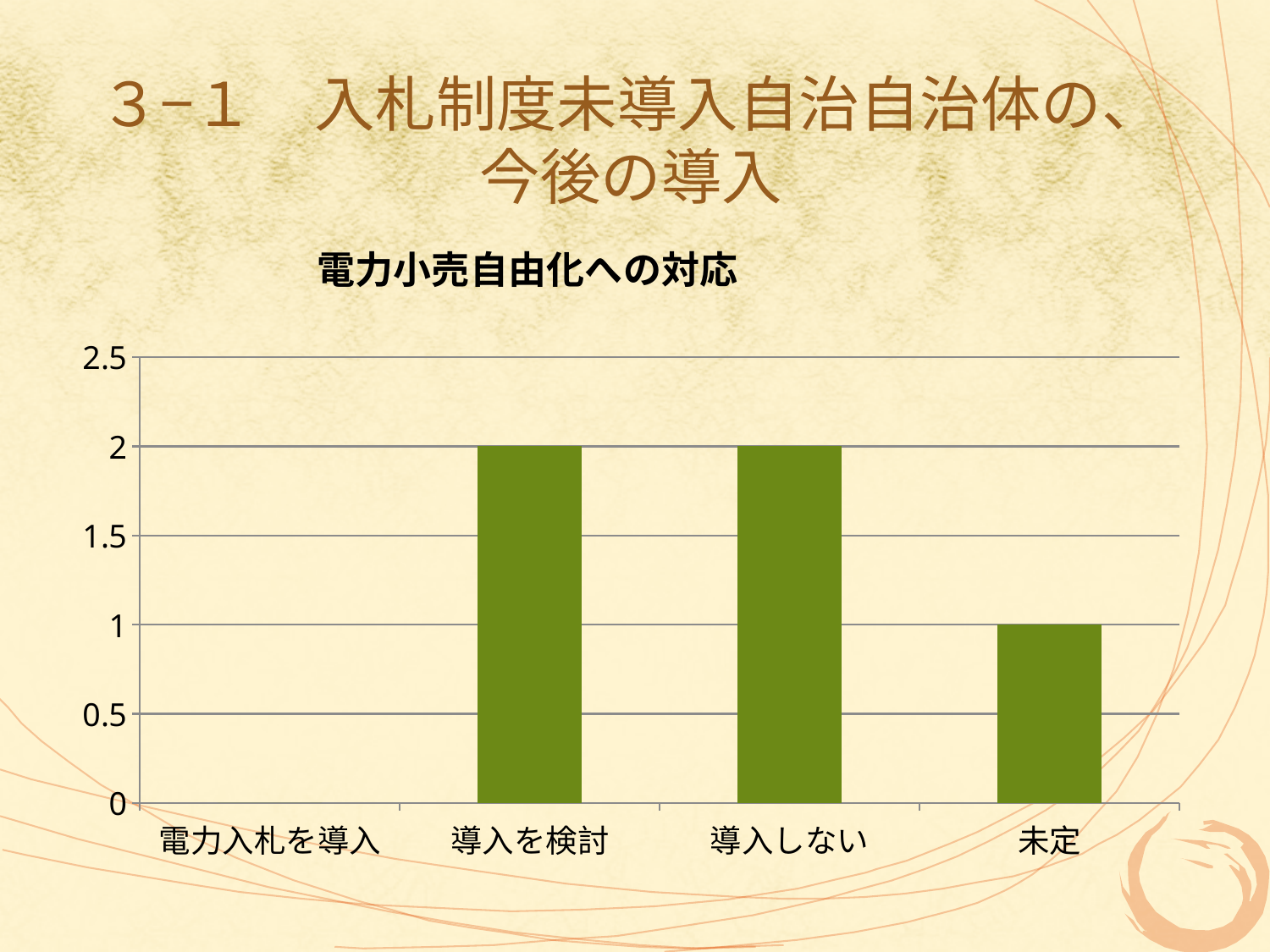
What is the value for 導入しない? 2 Which category has the lowest value? 電力入札を導入 What kind of chart is shown on the slide? bar chart How many categories are shown on the x axis of the chart? 4 What is the difference between the value for 導入しない and the value for 未定? 1 What is the value for 導入を検討? 2 What is the highest value shown on the y axis of the chart? 2.5 Which is larger, the value for 導入を検討 or the value for 未定? 導入を検討 What is the title of the chart? 電力小売自由化への対応 What is the value for 未定? 1 What is the value for 電力入札を導入? 0 Is the value for 未定 greater or less than 1.5? less